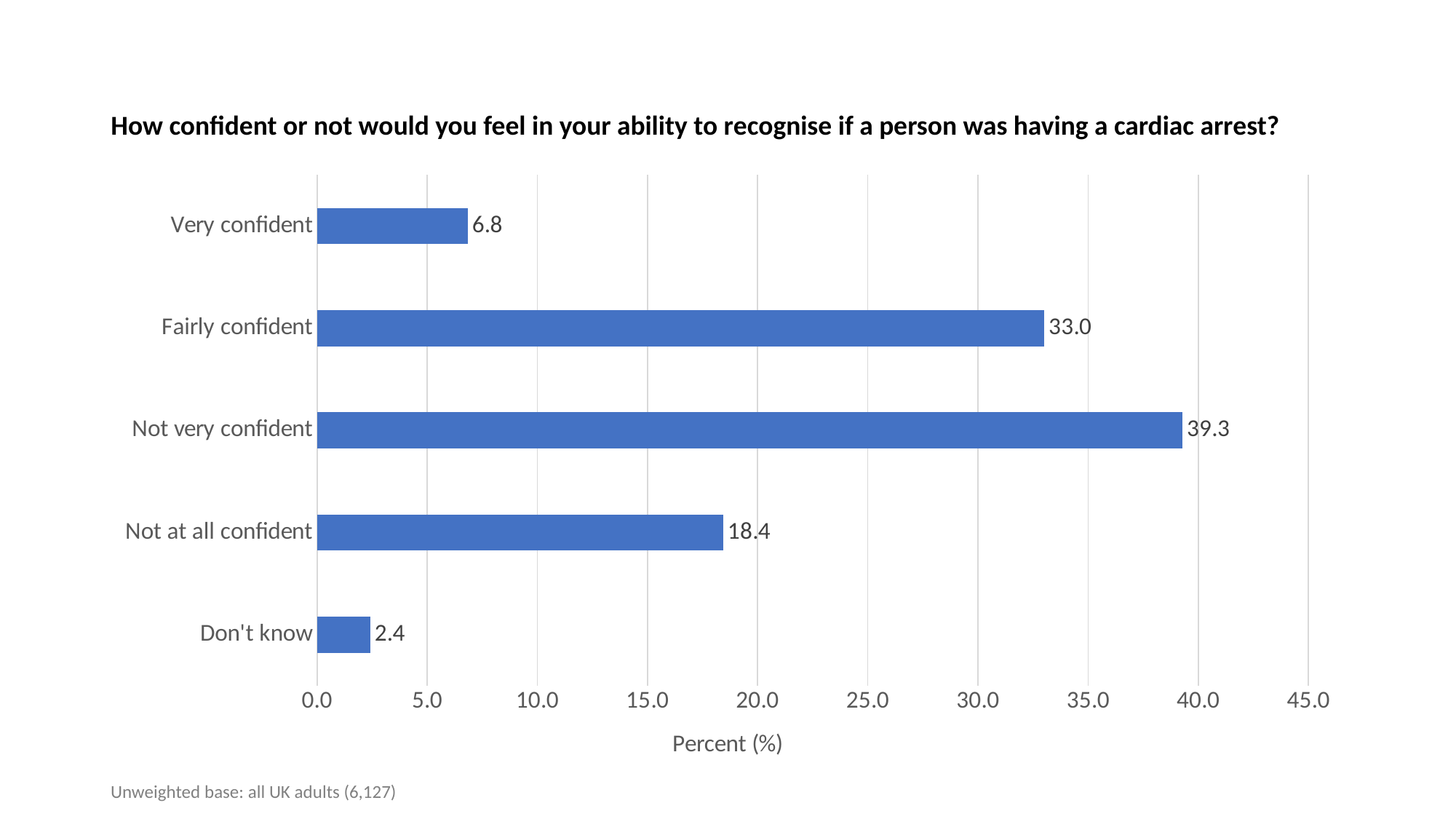
What is the value for Fairly confident? 33.0 How many categories are shown in the chart? 5 Which category has the highest value? Not very confident What is the value for Don't know? 2.4 What is the label of the horizontal axis? Percent (%) Which category has the lowest value? Don't know Is the value for Fairly confident greater or less than 30.0? greater What is the difference between the values for Not at all confident and Very confident? 11.6 What is the difference between the values for Not very confident and Fairly confident? 6.3 Which is larger, the value for Very confident or the value for Not at all confident? Not at all confident What kind of chart is shown on the slide? Bar chart What is the value for Not at all confident? 18.4